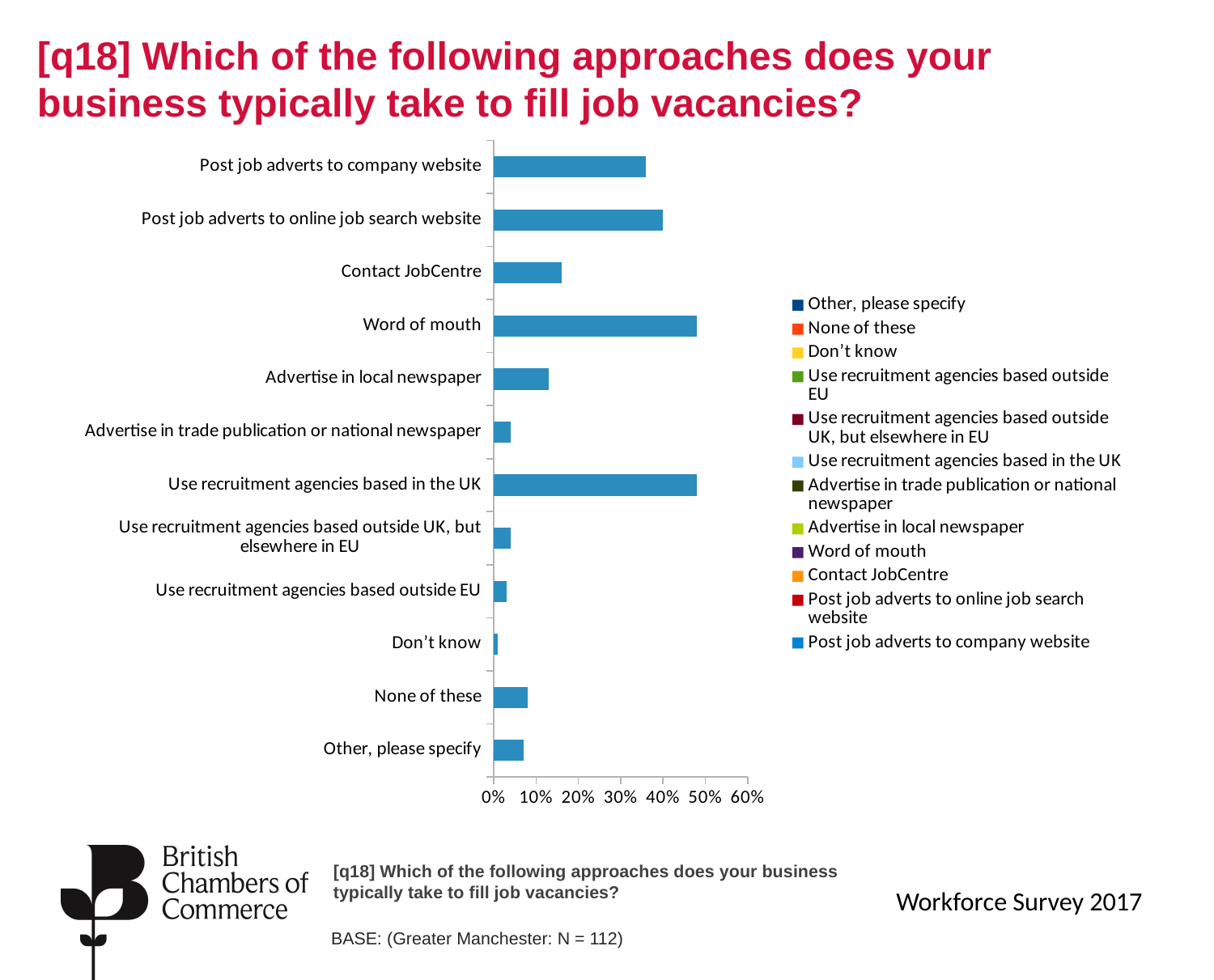
How many entries does the chart's legend list? 12 Is the value for Contact JobCentre greater or less than 10%? greater Is the value for Advertise in trade publication or national newspaper greater or less than 10%? less Is the value for Post job adverts to company website greater or less than 30%? greater How many categories (approaches) are plotted on the chart? 12 What is the highest percentage tick shown on the horizontal axis? 60% Which category has the lowest value on the chart? Don't know What kind of chart is shown on the slide? Bar chart Which is larger: the value for Contact JobCentre or the value for Advertise in trade publication or national newspaper? Contact JobCentre